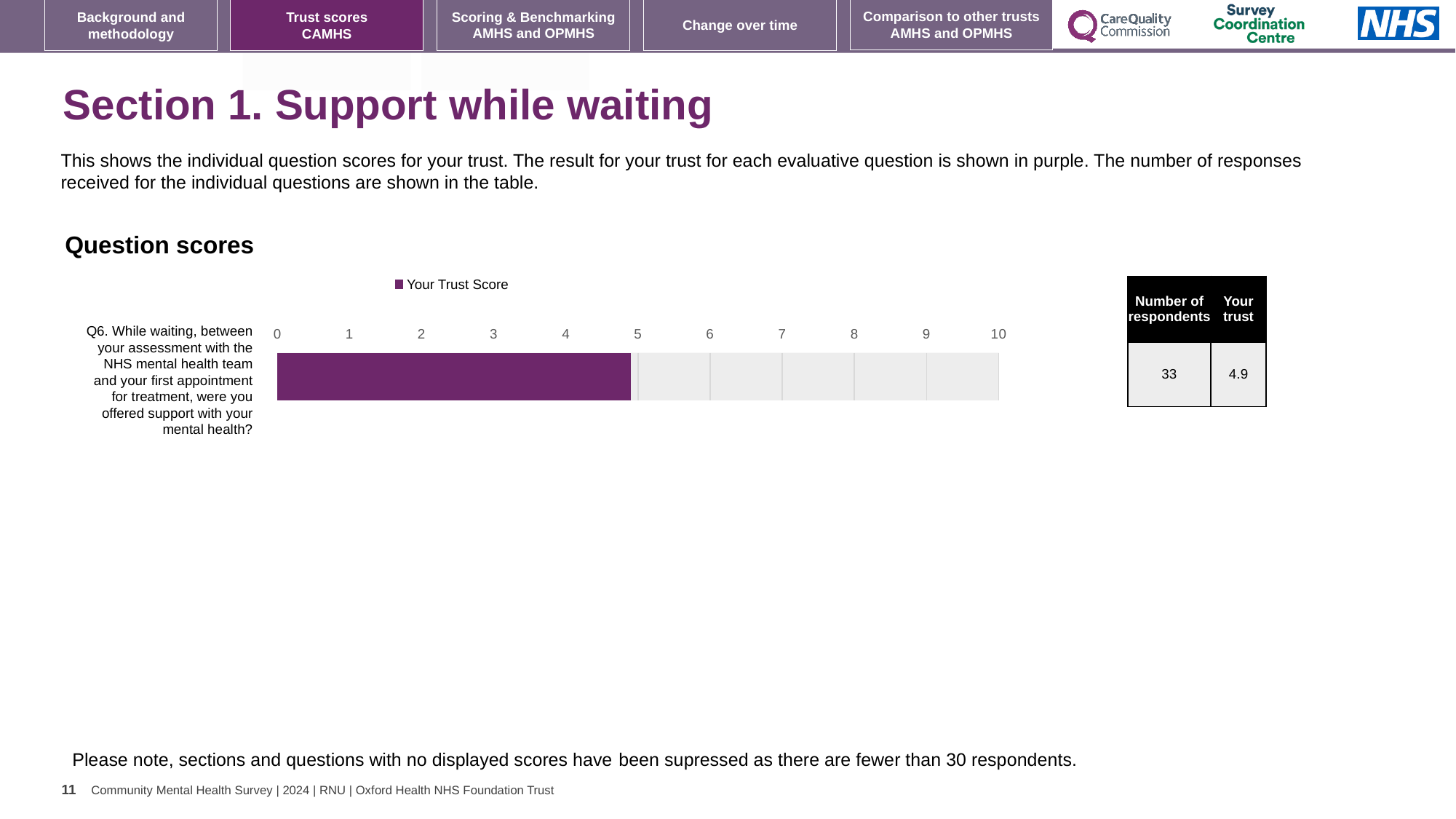
Is the trust score bar for Q6 greater or less than 4? greater What kind of chart is shown under 'Question scores'? bar chart What is the legend entry shown for the 'Question scores' chart? Your Trust Score Is the trust score bar for Q6 greater or less than 5? less What is the maximum value shown on the x axis of the 'Question scores' chart? 10 How many questions (bars) are plotted in the 'Question scores' chart? 1 How many series does the legend of the 'Question scores' chart list? 1 How many respondents answered Q6 according to the table beside the chart? 33 What is the trust score for Q6 (support while waiting) as shown in the table next to the chart? 4.9